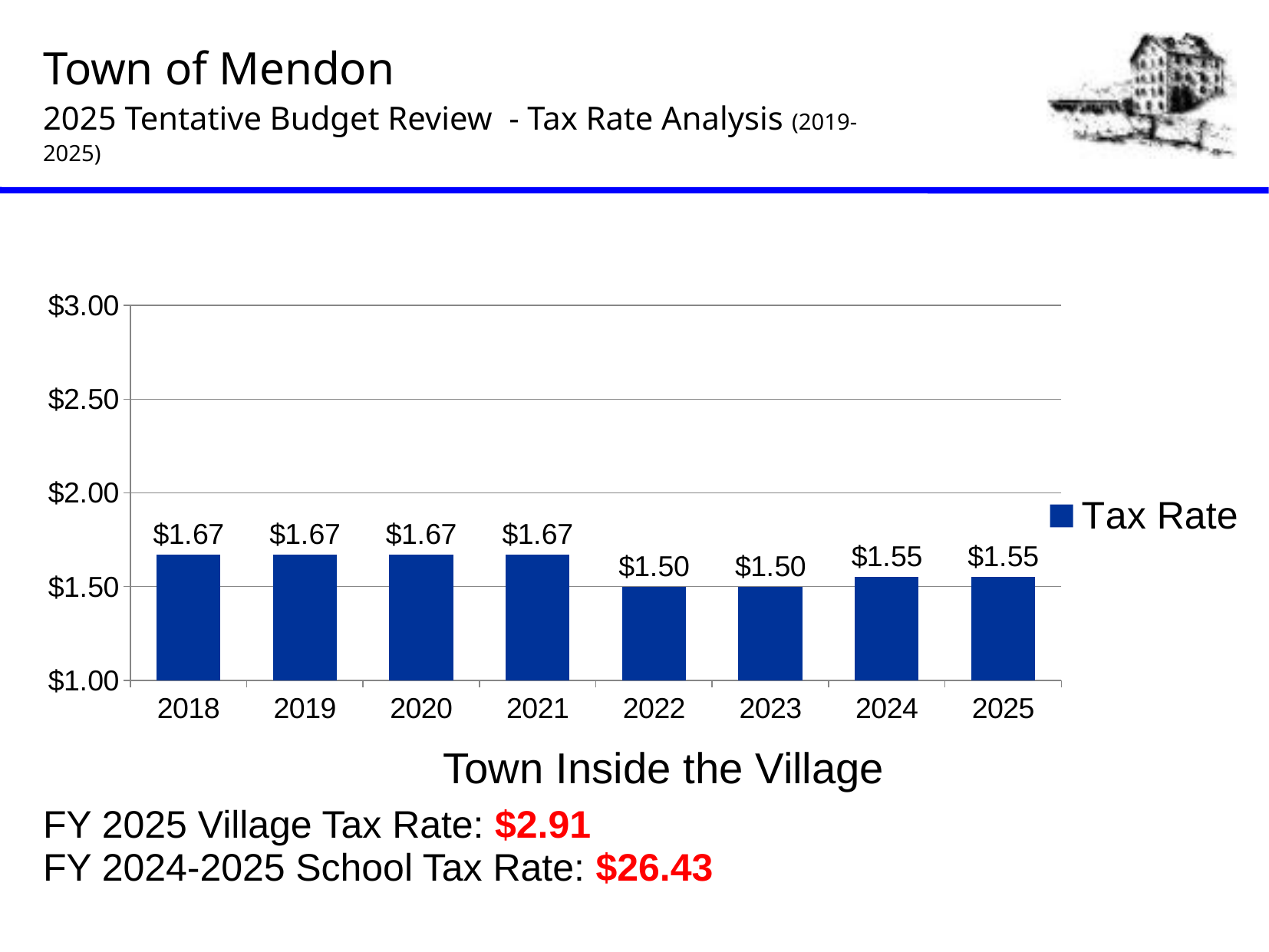
What is the tax rate for 2022? $1.50 What is the tax rate for 2018? $1.67 How many series does the chart legend list? 1 What is the tax rate for 2025? $1.55 What is the difference between the tax rate in 2021 and the tax rate in 2022? $0.17 Is the tax rate for 2020 greater or less than $1.50? greater What kind of chart is shown on the slide? bar chart Is the tax rate for 2025 greater or less than $2.00? less What is the difference between the tax rate in 2024 and the tax rate in 2023? $0.05 What is the title shown below the chart's x axis? Town Inside the Village How many years are shown on the x axis of the chart? 8 Which year has the lowest tax rate, 2022 or 2024? 2022